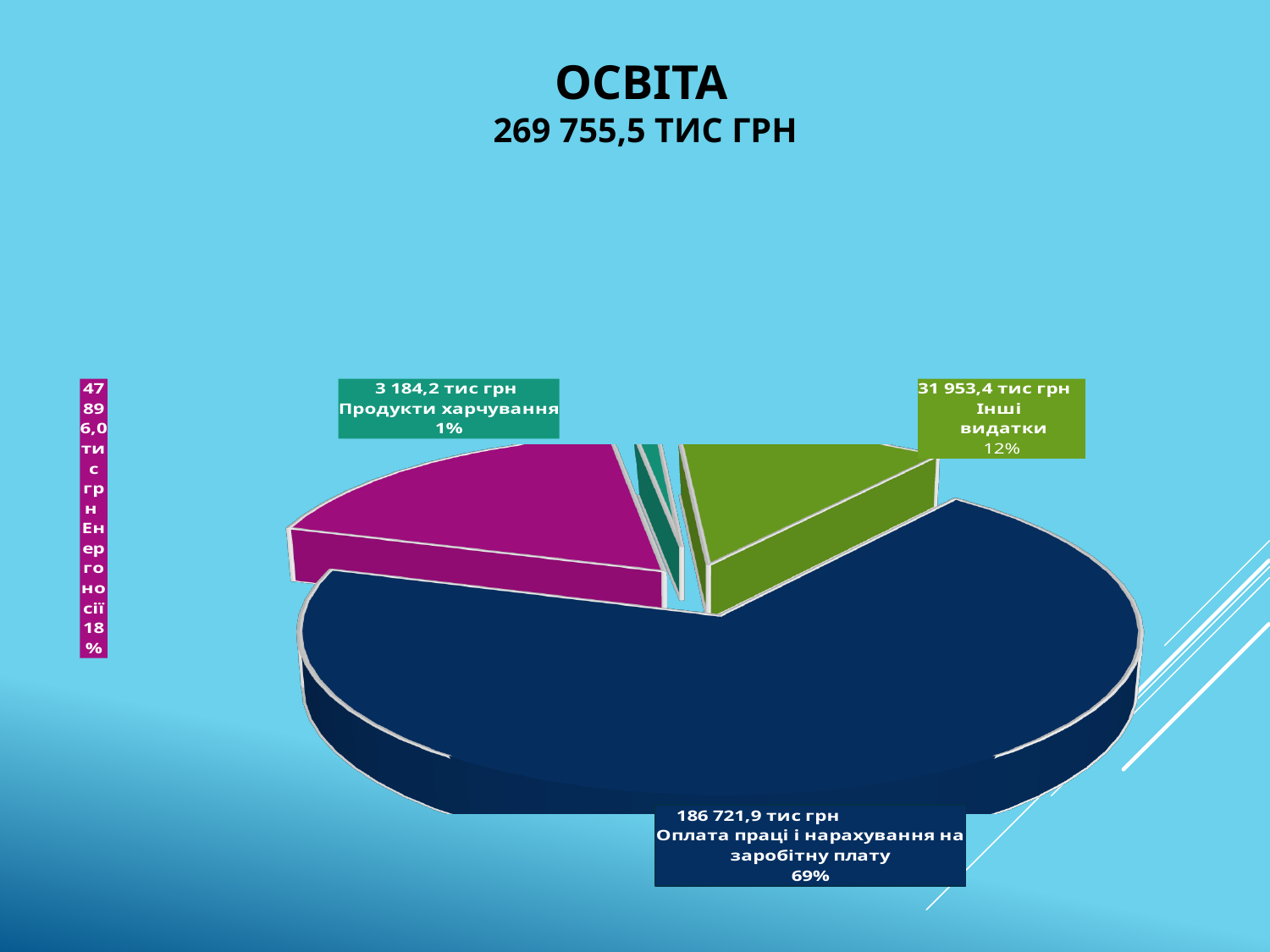
What is the value for Продукти харчування? 3 184,2 тис грн What is the value for Оплата праці і нарахування на заробітну плату? 186 721,9 тис грн What share of the pie does Енергоносії represent? 18% Which category has the largest slice of the pie? Оплата праці і нарахування на заробітну плату What total amount is shown in the chart title? 269 755,5 тис грн What share of the pie does Інші видатки represent? 12% Which is larger, Інші видатки or Енергоносії? Енергоносії What is the value for Інші видатки? 31 953,4 тис грн What kind of chart is shown on the slide? Pie chart Which category has the smallest slice of the pie? Продукти харчування How many slices does the pie chart have? 4 What share of the pie does Оплата праці і нарахування на заробітну плату represent? 69%